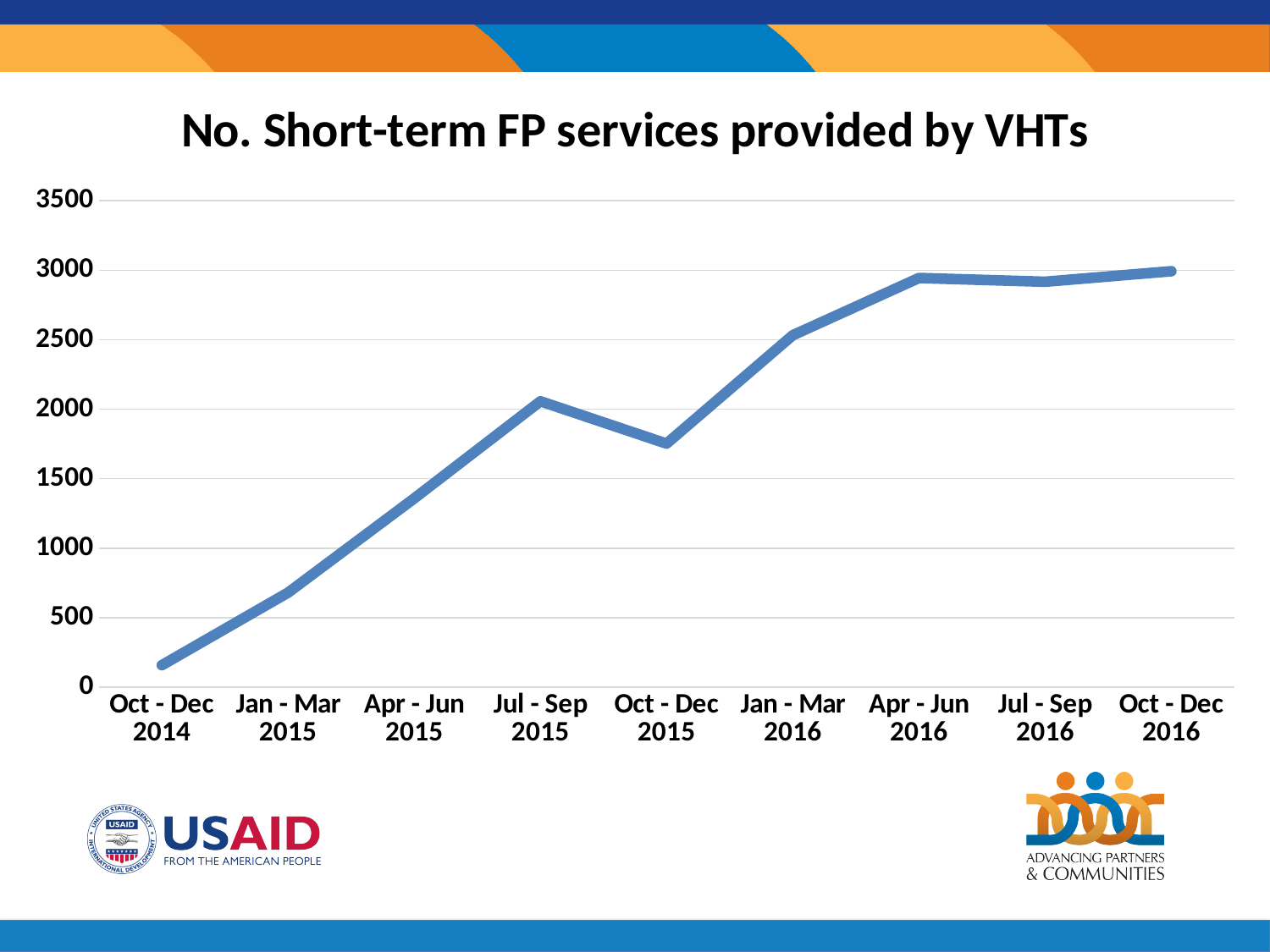
What is the title of the chart? No. Short-term FP services provided by VHTs Is the value for Oct - Dec 2014 greater or less than 500? less Is the value for Jan - Mar 2015 greater or less than 1000? less Is the value for Oct - Dec 2015 greater or less than 2000? less Which is larger, the value for Jul - Sep 2015 or the value for Oct - Dec 2015? Jul - Sep 2015 Which quarter has the lowest number of short-term FP services provided by VHTs? Oct - Dec 2014 Which is larger, the value for Jan - Mar 2016 or the value for Jan - Mar 2015? Jan - Mar 2016 What kind of chart is shown on the slide? Line chart How many quarterly points are plotted on the chart? 9 Overall, do the values rise or fall from Oct - Dec 2014 to Oct - Dec 2016? Rise